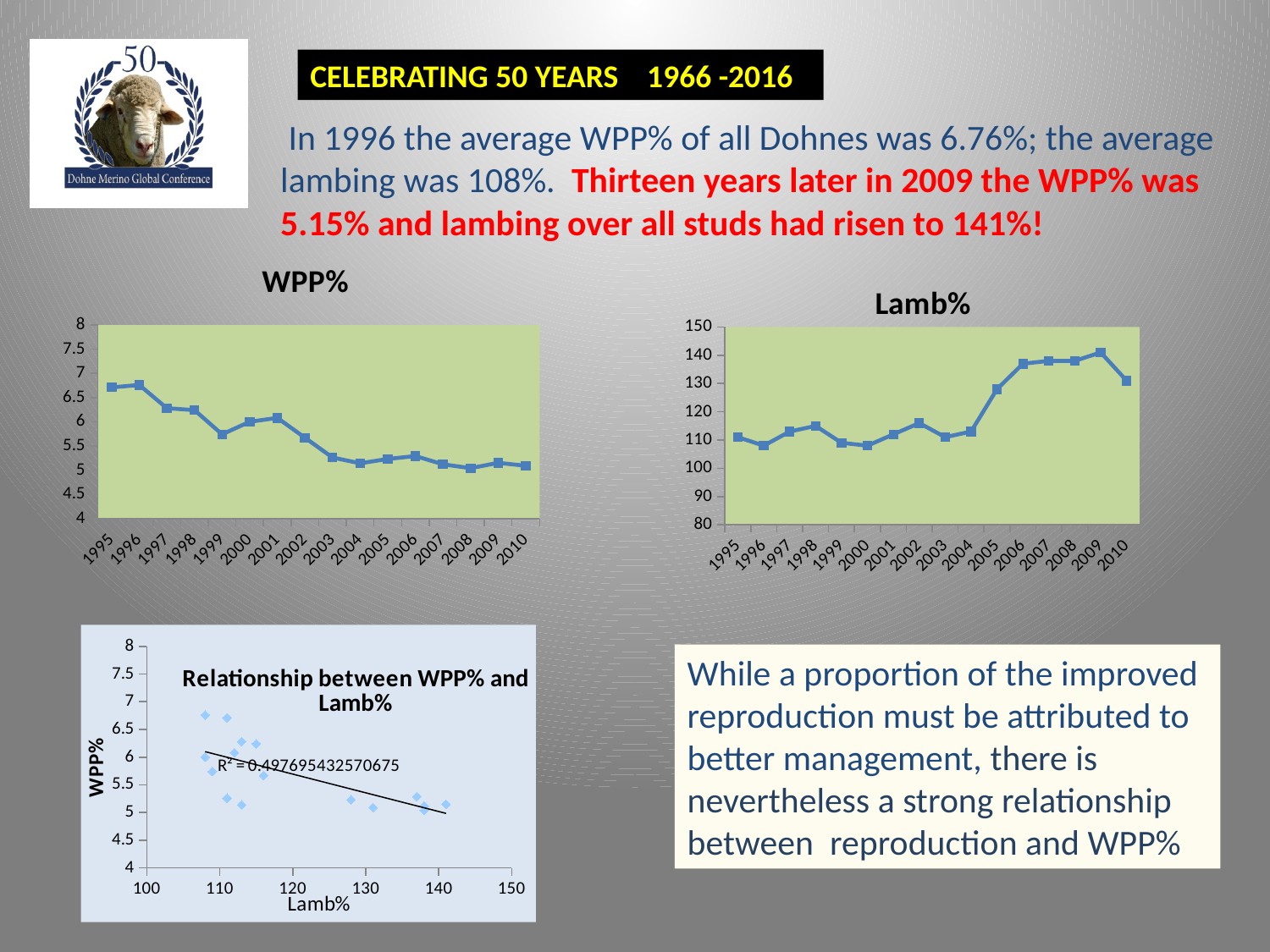
In the Lamb% chart, is the value for 2005 greater or less than 120? greater In the WPP% chart, do the values generally rise or fall from 1995 to 2010? fall What kind of chart is the WPP% chart at the top left? line chart In the Lamb% chart, do the values generally rise or fall from 1995 to 2010? rise What R² value is printed on the 'Relationship between WPP% and Lamb%' chart? R² = 0.497695432570675 What kind of chart is the bottom-left chart titled 'Relationship between WPP% and Lamb%'? scatter chart In the WPP% chart, is the value for 2004 greater or less than 5.5? less In the Lamb% chart, is the value for 1996 greater or less than 110? less How many years are shown on the x axis of the WPP% chart? 16 In the WPP% chart, which is larger, the value for 1997 or the value for 2003? 1997 In the Lamb% chart, which year has the highest value? 2009